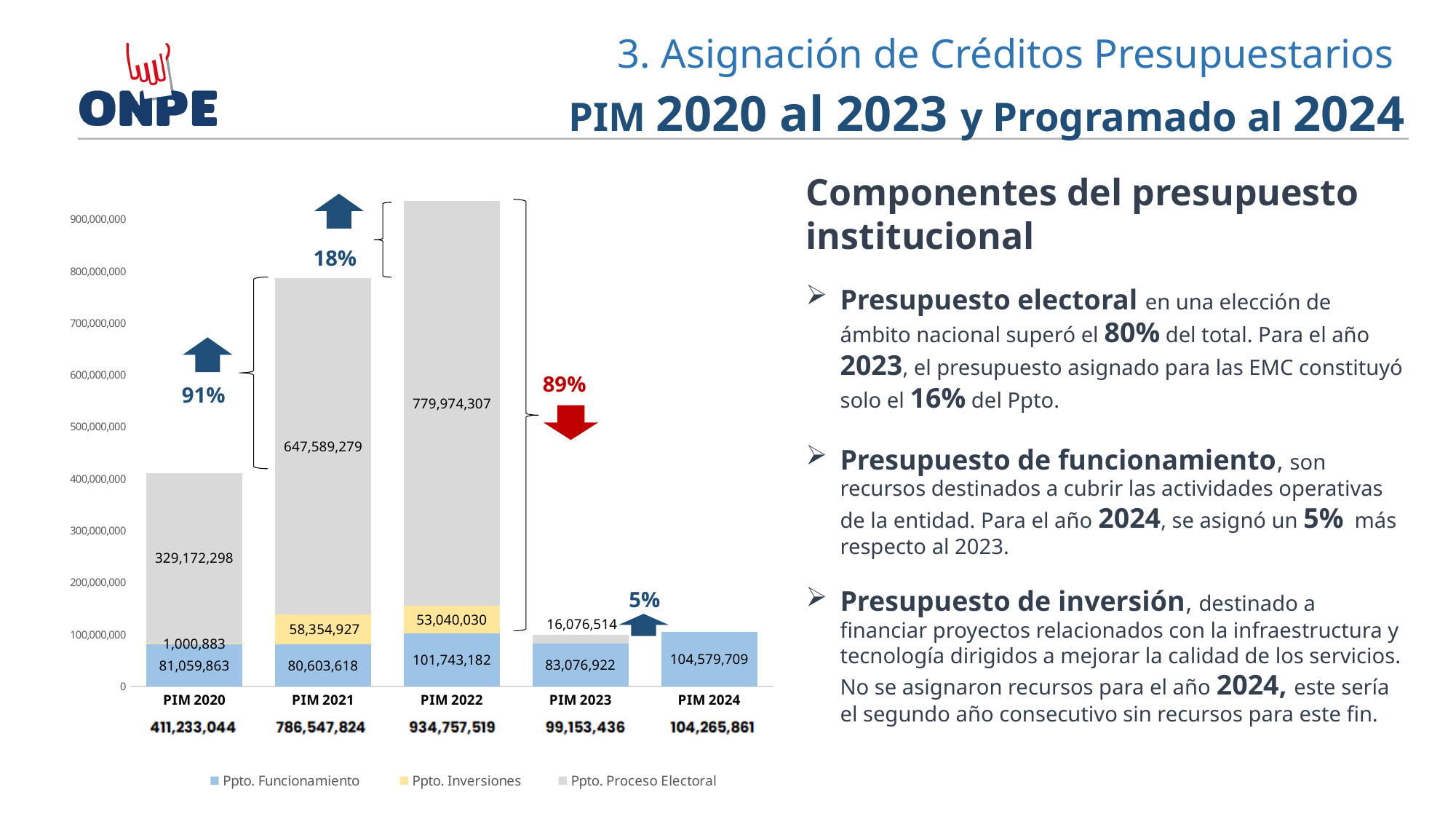
Which year has the highest value for Ppto. Proceso Electoral? PIM 2022 What is the value of Ppto. Proceso Electoral for PIM 2023? 16,076,514 What is the value of Ppto. Inversiones for PIM 2020? 1,000,883 What kind of chart is shown on the slide? Stacked bar chart What is the value of Ppto. Funcionamiento for PIM 2022? 101,743,182 What is the difference between Ppto. Inversiones in PIM 2021 and PIM 2022? 5,314,897 How many categories (years) are shown on the x axis of the chart? 5 How many series does the chart legend list? 3 What is the total printed for the PIM 2020 bar? 411,233,044 What is the value of Ppto. Proceso Electoral for PIM 2021? 647,589,279 What percentage change is shown between the PIM 2022 and PIM 2023 bars? 89% Which is larger, Ppto. Funcionamiento for PIM 2024 or for PIM 2023? PIM 2024